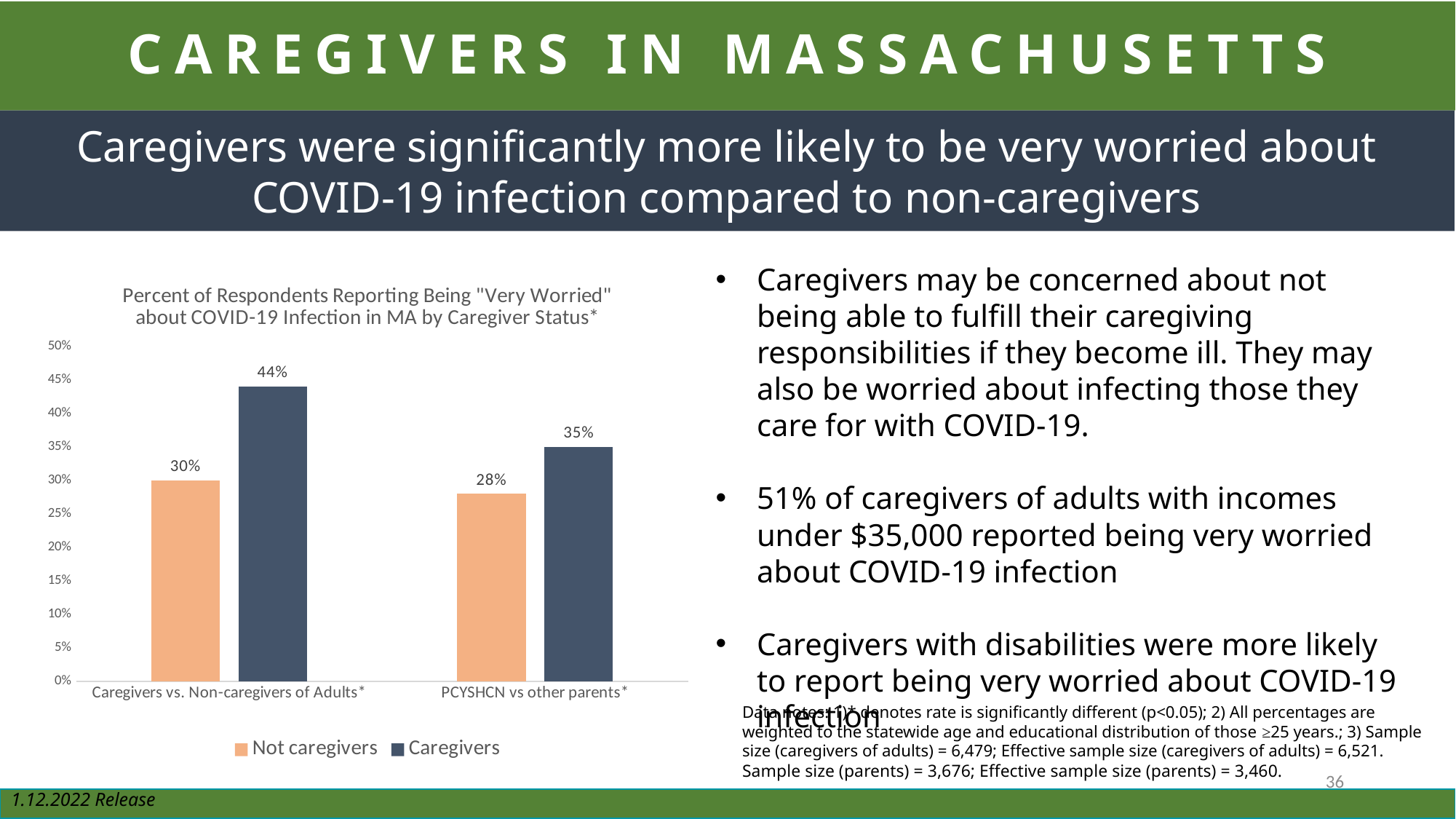
Which bar has the lowest value in the chart? Not caregivers, PCYSHCN vs other parents* What percentage of caregivers in the "Caregivers vs. Non-caregivers of Adults*" group reported being very worried? 44% How many series does the legend list? 2 Which is larger: the Caregivers value for "PCYSHCN vs other parents*" or the Not caregivers value for "Caregivers vs. Non-caregivers of Adults*"? Caregivers value for PCYSHCN vs other parents* What is the difference between Caregivers and Not caregivers in the "Caregivers vs. Non-caregivers of Adults*" group? 14% What percentage of non-caregivers in the "Caregivers vs. Non-caregivers of Adults*" group reported being very worried? 30% Which bar has the highest value in the chart? Caregivers, Caregivers vs. Non-caregivers of Adults* What is the value for Caregivers in the "PCYSHCN vs other parents*" group? 35% What is the value for Not caregivers in the "PCYSHCN vs other parents*" group? 28% How many category groups are shown on the x axis? 2 What is the difference between Caregivers and Not caregivers in the "PCYSHCN vs other parents*" group? 7% What type of chart is shown on the slide? Bar chart